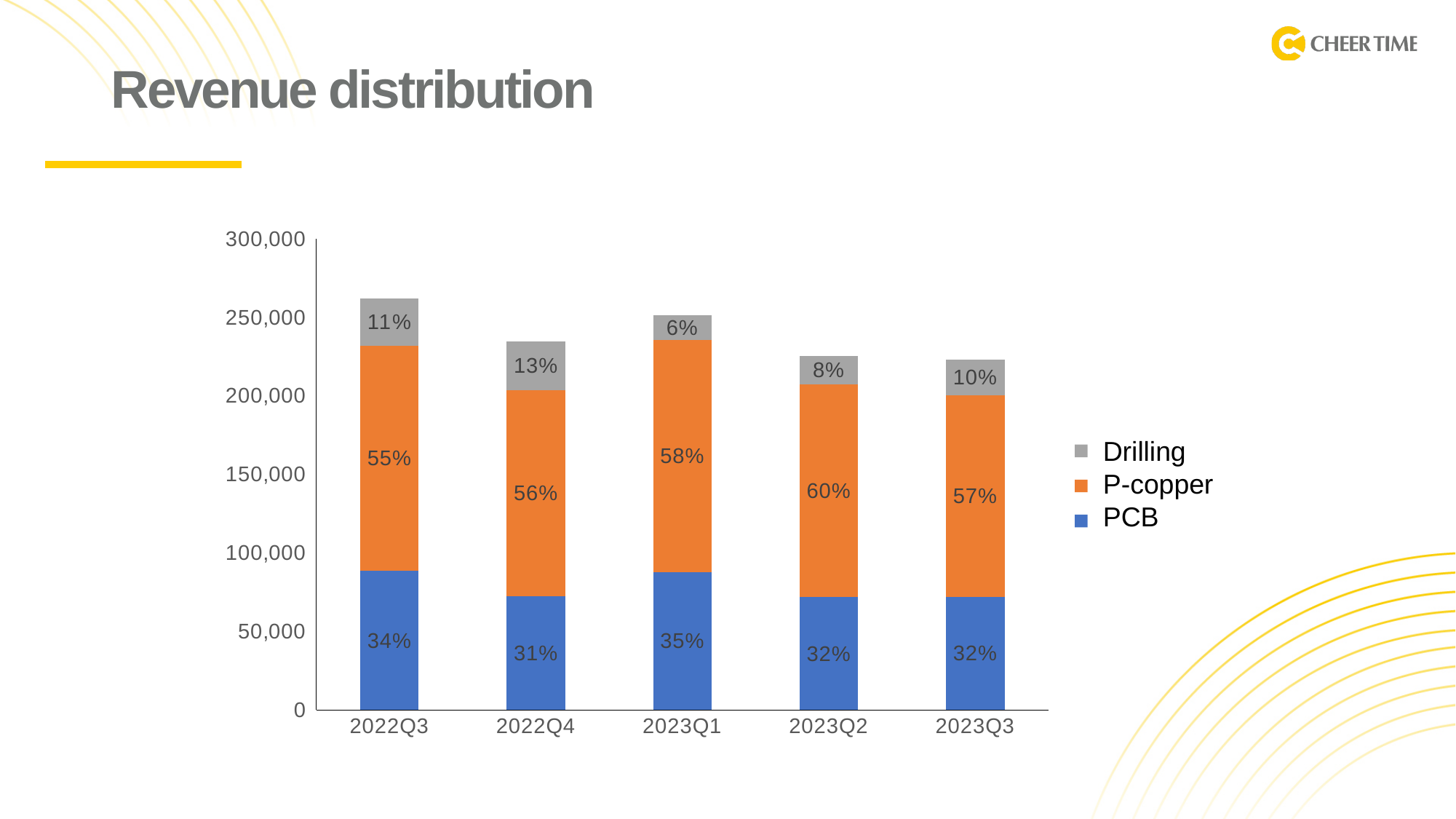
What is the PCB share in 2023Q1? 35% What percentage share does P-copper have in 2023Q2? 60% How many quarters are shown on the x axis? 5 Is the total revenue bar for 2022Q4 greater or less than 250,000? less Is the total revenue bar for 2022Q3 greater or less than 250,000? greater By how many percentage points does the P-copper share exceed the PCB share in 2022Q3? 21 percentage points In which quarter is the P-copper share the highest? 2023Q2 What is the Drilling share label for 2022Q4? 13% Which is larger, the Drilling share in 2022Q3 or in 2023Q3? 2022Q3 In which quarter is the Drilling share the lowest? 2023Q1 How many series does the legend list? 3 In which quarter is the PCB share the lowest? 2022Q4